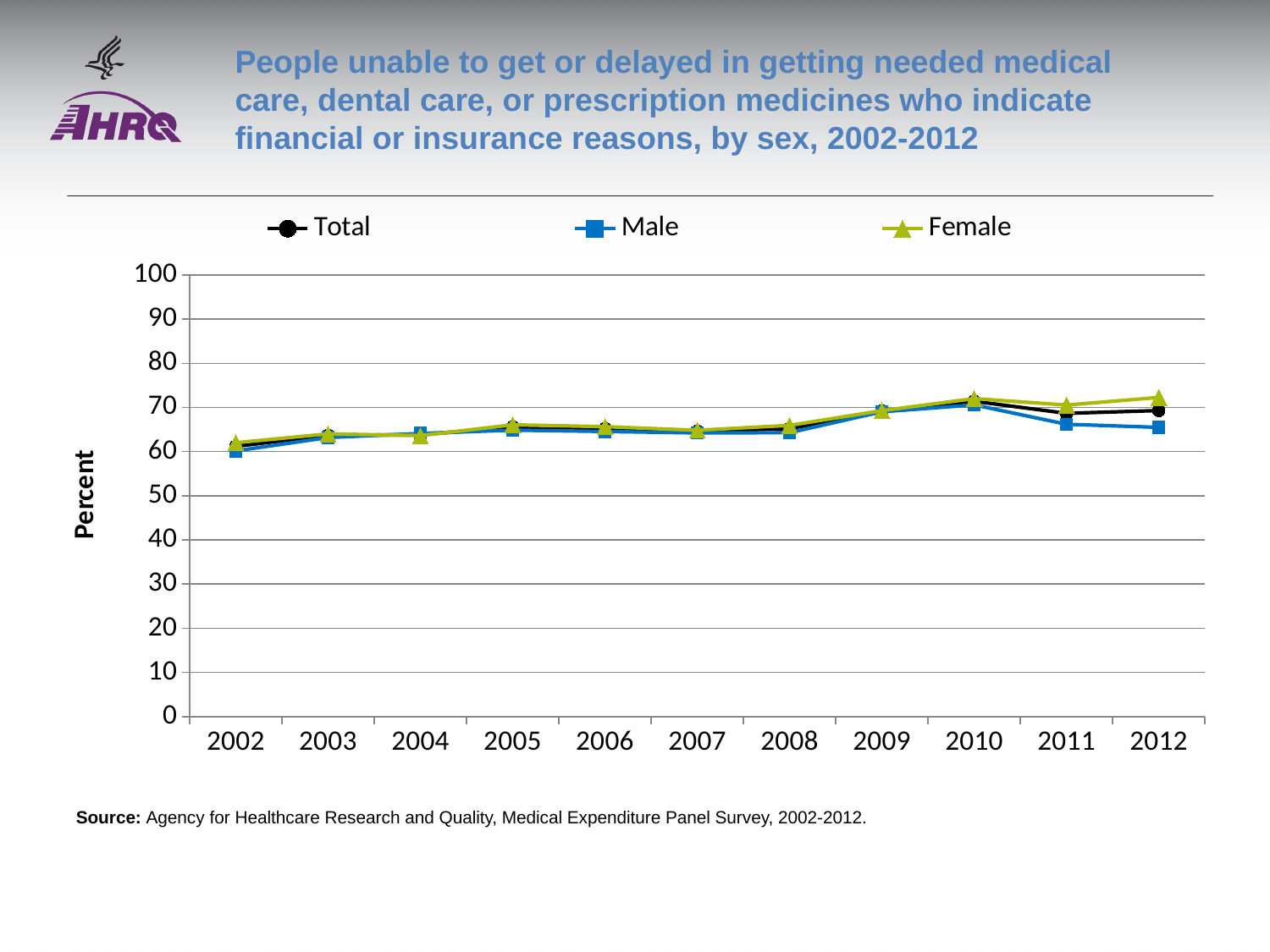
In which year is the Male value highest? 2010 Is the Female value for 2010 greater or less than 70? greater Which series are listed in the legend? Total, Male, Female How many years are plotted along the x axis? 11 In which year is the Total value highest? 2010 How many series does the legend list? 3 In 2012, which is larger, the Male value or the Female value? Female Does the Male value rise or fall from 2010 to 2012? fall What type of chart is shown on the slide? line chart Is the Male value for 2012 greater or less than 70? less What is the label of the y axis? Percent In which year is the Male value lowest? 2002